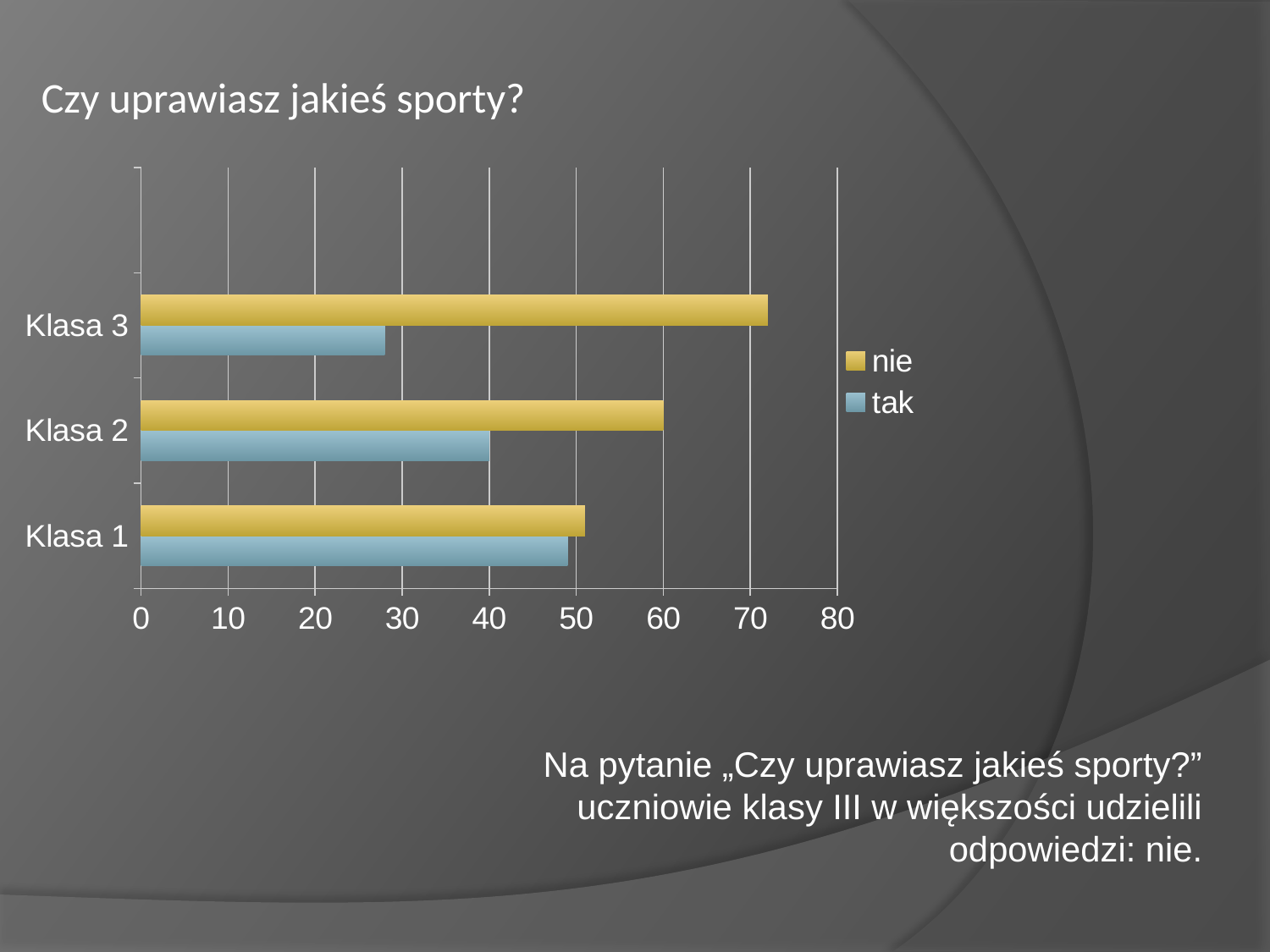
What is the value of "tak" for Klasa 2? 40 Which class has the lowest value for "tak"? Klasa 3 What is the title of the chart? Czy uprawiasz jakieś sporty? Which class has the highest value for "nie"? Klasa 3 What is the value of "nie" for Klasa 2? 60 For Klasa 3, which is larger, "nie" or "tak"? nie Is the value of "tak" for Klasa 3 greater or less than 40? less How many classes (categories) are shown on the chart? 3 Is the value of "nie" for Klasa 3 greater or less than 60? greater What is the difference between "nie" and "tak" for Klasa 2? 20 How many series does the legend list? 2 What kind of chart is shown on the slide? bar chart